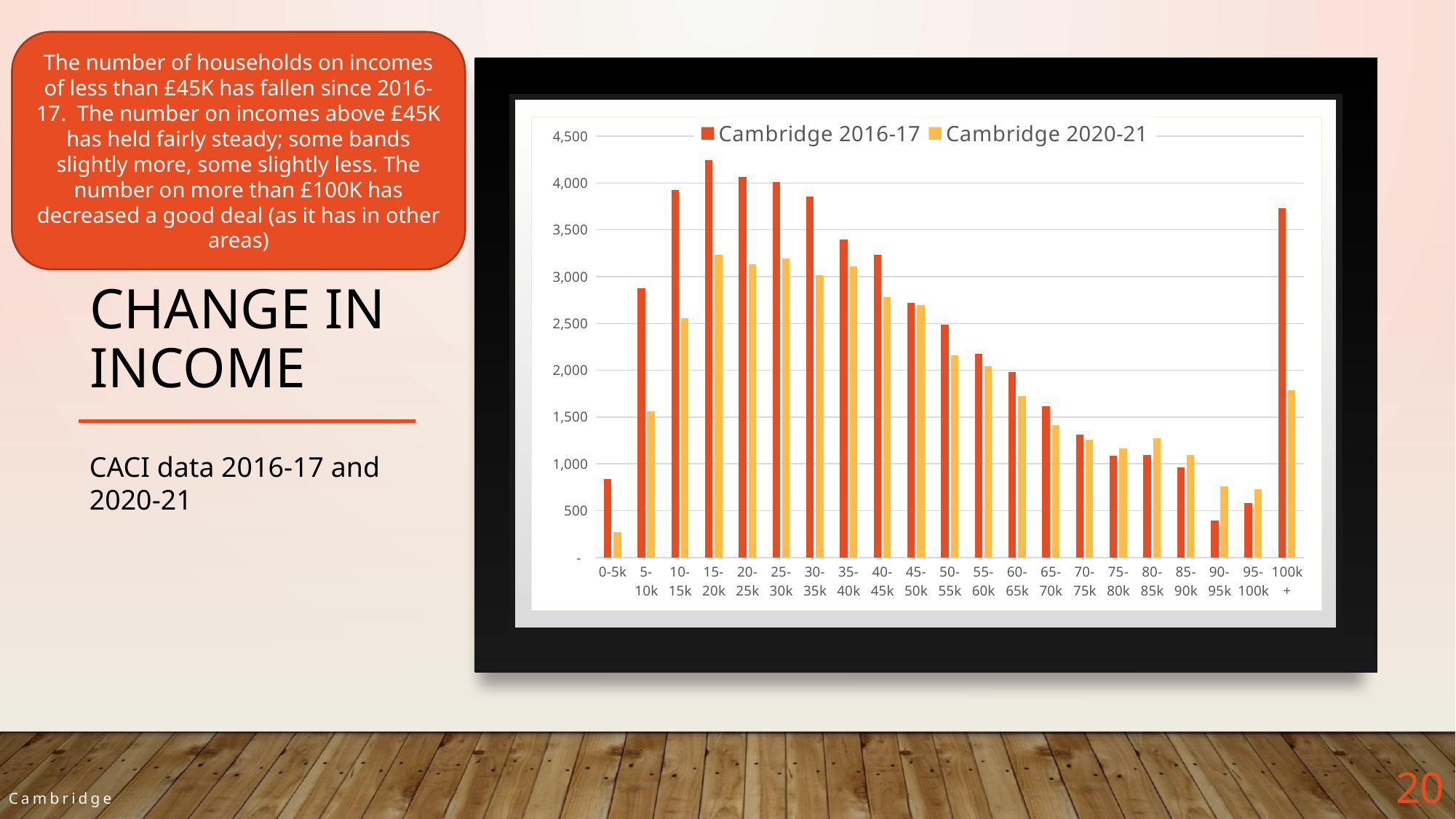
For the 100k+ band, which series has the larger value, Cambridge 2016-17 or Cambridge 2020-21? Cambridge 2016-17 What kind of chart is shown on the slide? bar chart How many series does the chart legend list? 2 Is the Cambridge 2016-17 value for 100k+ greater or less than 3,500? greater How many income bands are shown on the x axis of the chart? 21 Do the Cambridge 2016-17 values rise or fall from the 15-20k band to the 90-95k band? fall Is the Cambridge 2020-21 value for 100k+ greater or less than 2,000? less Which income band has the highest value for Cambridge 2016-17? 15-20k Which income band has the lowest value for Cambridge 2016-17? 90-95k Which income band has the lowest value for Cambridge 2020-21? 0-5k Is the Cambridge 2016-17 value for 0-5k greater or less than 500? greater For the 90-95k band, which series has the larger value, Cambridge 2016-17 or Cambridge 2020-21? Cambridge 2020-21